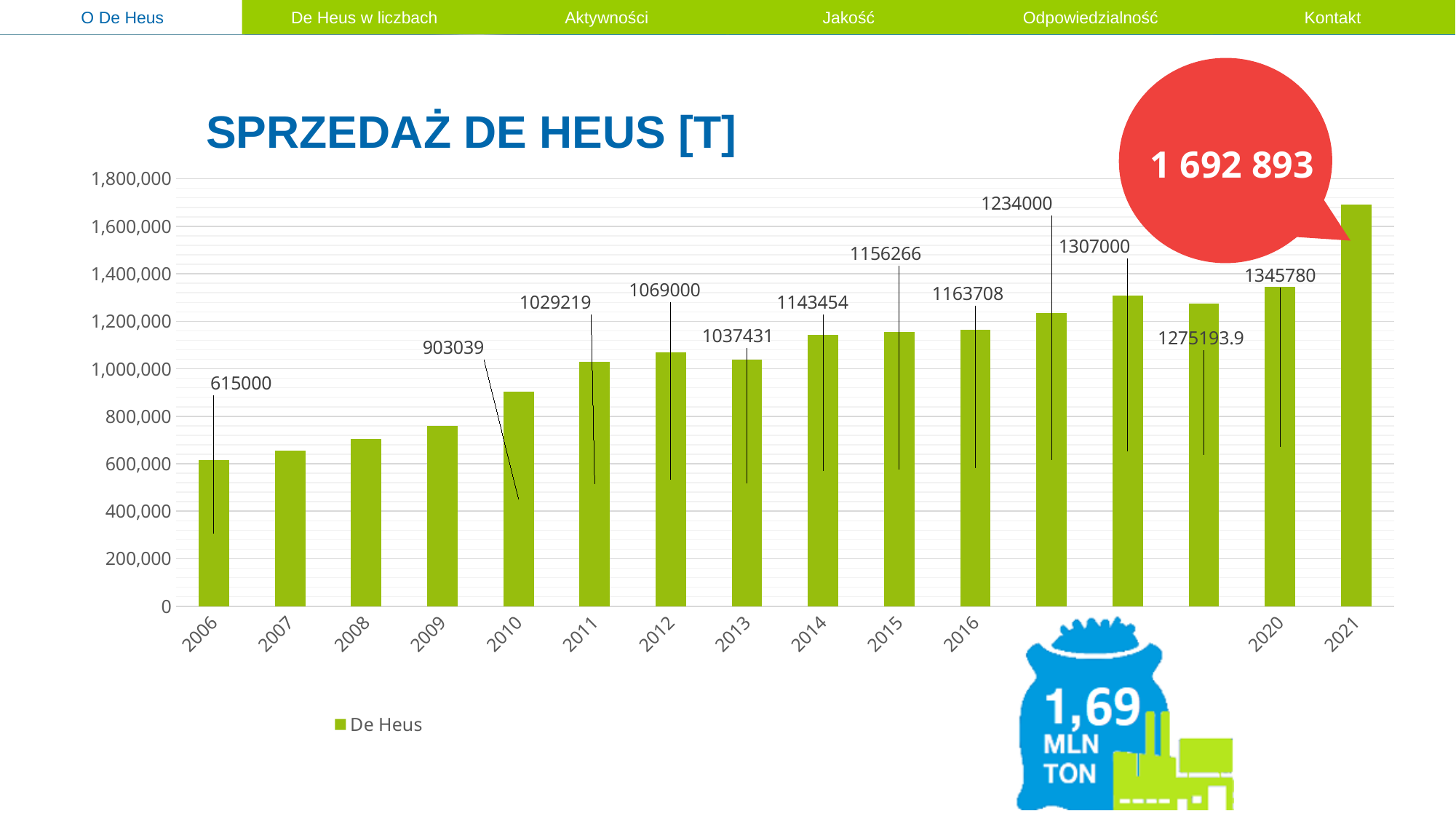
Is the value for 2008 greater or less than 800,000? less Which year has the highest value in the chart? 2021 Do the values generally rise or fall from 2006 to 2021? rise Which is larger, the value for 2012 or the value for 2013? 2012 What is the value for 2020 in the chart? 1345780 Which year has the lowest value in the chart? 2006 What is the value for 2014 in the chart? 1143454 What is the difference between the values for 2012 and 2011? 39781 What is the value for 2010 in the chart? 903039 How many series does the legend list? 1 How many bars (years) are shown in the chart? 16 What is the value for 2006 in the chart? 615000